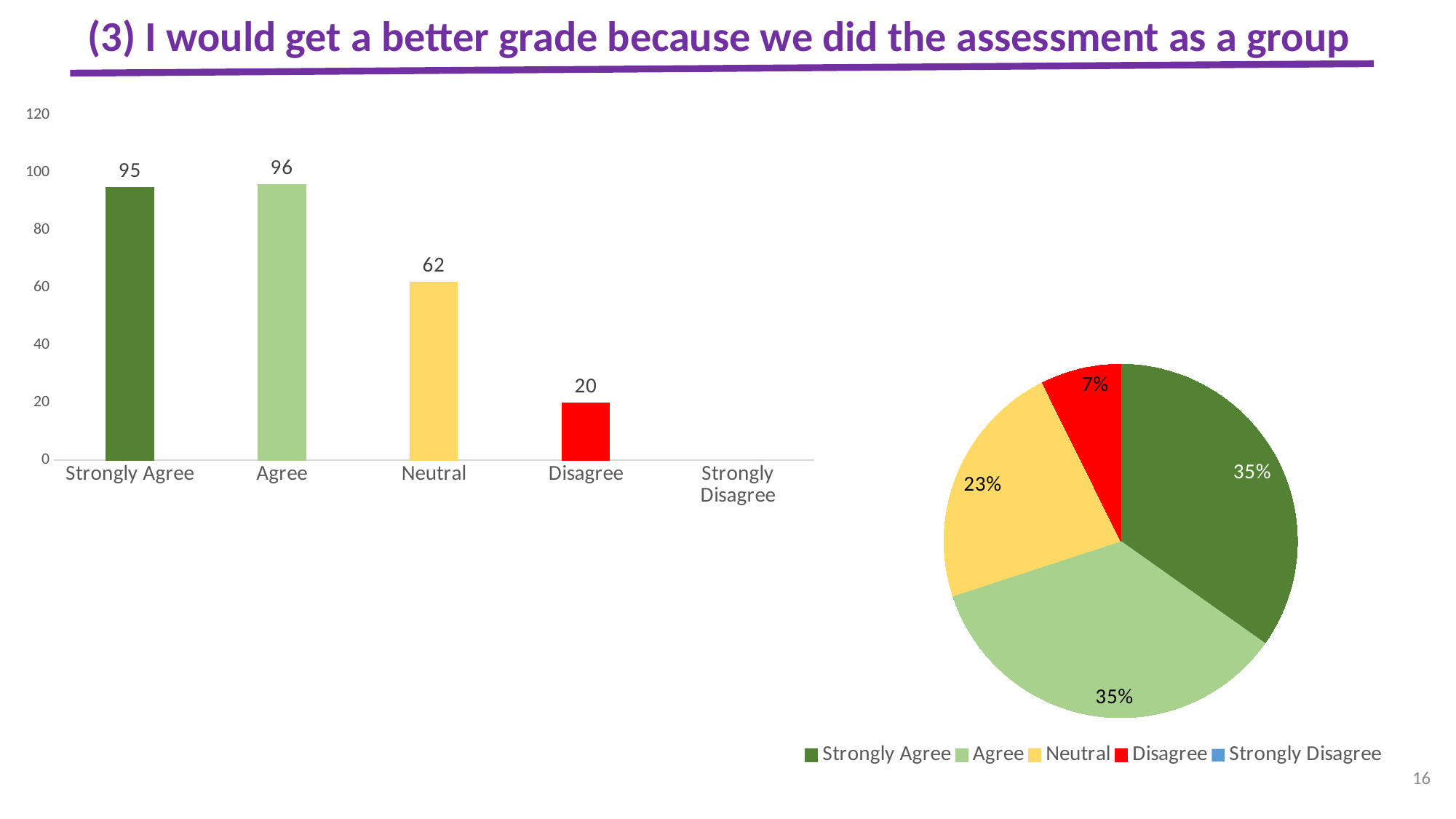
What kind of chart is on the left of the slide? bar chart In the bar chart on the left, how many categories are shown on the x axis? 5 In the bar chart on the left, what is the difference between the values for Strongly Agree and Disagree? 75 In the pie chart on the right, how many entries does the legend list? 5 In the pie chart on the right, what share does Neutral have? 23% In the bar chart on the left, what is the value for Neutral? 62 In the bar chart on the left, what is the value for Agree? 96 In the bar chart on the left, which category has the highest value? Agree What kind of chart is on the right of the slide? pie chart In the bar chart on the left, what is the value for Disagree? 20 In the bar chart on the left, what is the difference between the values for Agree and Neutral? 34 In the bar chart on the left, which is larger, the value for Neutral or the value for Disagree? Neutral